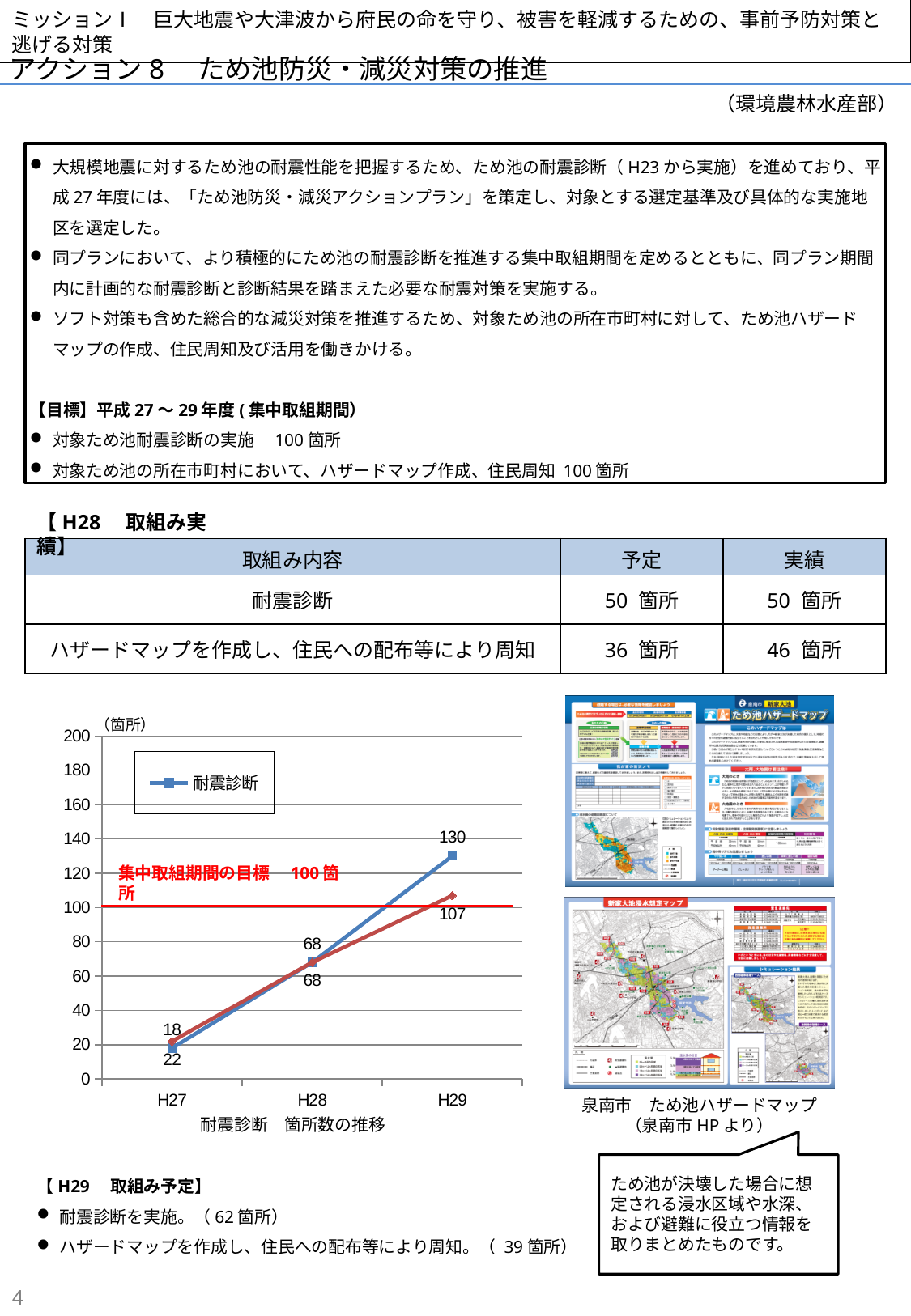
In the 耐震診断 箇所数の推移 chart, what is the highest value labelled on the blue line? 130 What kind of chart is shown at the bottom left of the slide (耐震診断 箇所数の推移)? line chart What series name appears in the legend of the 耐震診断 箇所数の推移 chart? 耐震診断 In the 耐震診断 箇所数の推移 chart, what is the value of the red horizontal target line (集中取組期間の目標)? 100箇所 What is the unit shown at the top of the y axis of the 耐震診断 箇所数の推移 chart? 箇所 In the 耐震診断 箇所数の推移 chart, what is the difference between the two values labelled at H29 (130 and 107)? 23 In the 耐震診断 箇所数の推移 chart, is the blue line's value at H29 greater or less than 100? greater How many series does the legend of the 耐震診断 箇所数の推移 chart list? 1 How many categories are on the x axis of the 耐震診断 箇所数の推移 chart? 3 In the 耐震診断 箇所数の推移 chart, do the plotted values rise or fall from H27 to H29? rise In the 耐震診断 箇所数の推移 chart, what value is labelled for H28? 68 In the 耐震診断 箇所数の推移 chart, which is larger at H29: the blue line's value or the red line's value? the blue line's value